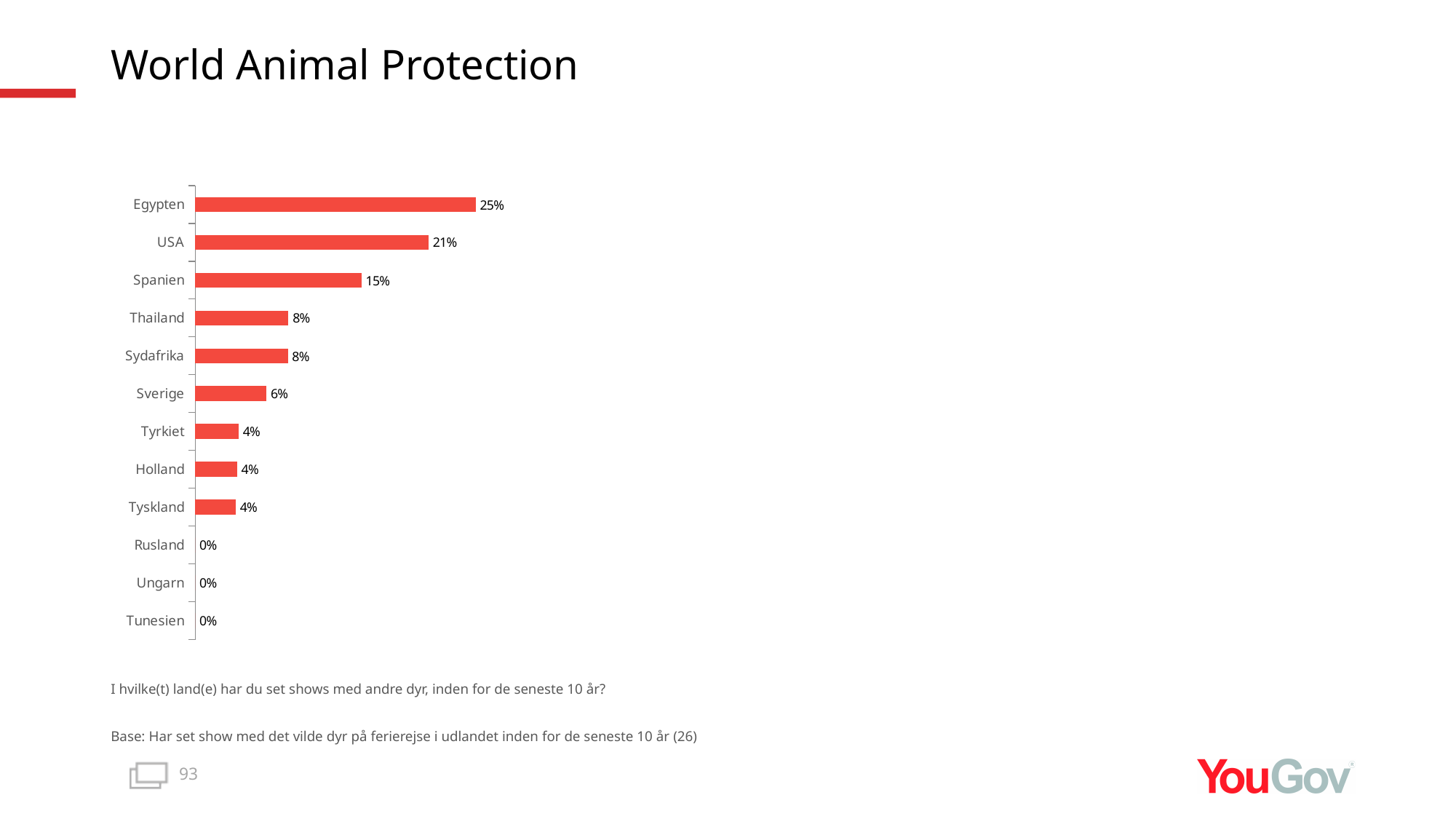
Which country has the highest value? Egypten Which is larger, the value for USA or the value for Spanien? USA Which is larger, the value for Sverige or the value for Tyrkiet? Sverige What is the value for Egypten? 25% What is the difference between the values for Egypten and USA? 4% What is the difference between the values for Spanien and Thailand? 7% How many countries have a value of 0%? 3 What is the value for Spanien? 15% What is the value for Sverige? 6% What is the value for Rusland? 0% How many countries are shown in the chart? 12 What kind of chart is shown on the slide? Bar chart